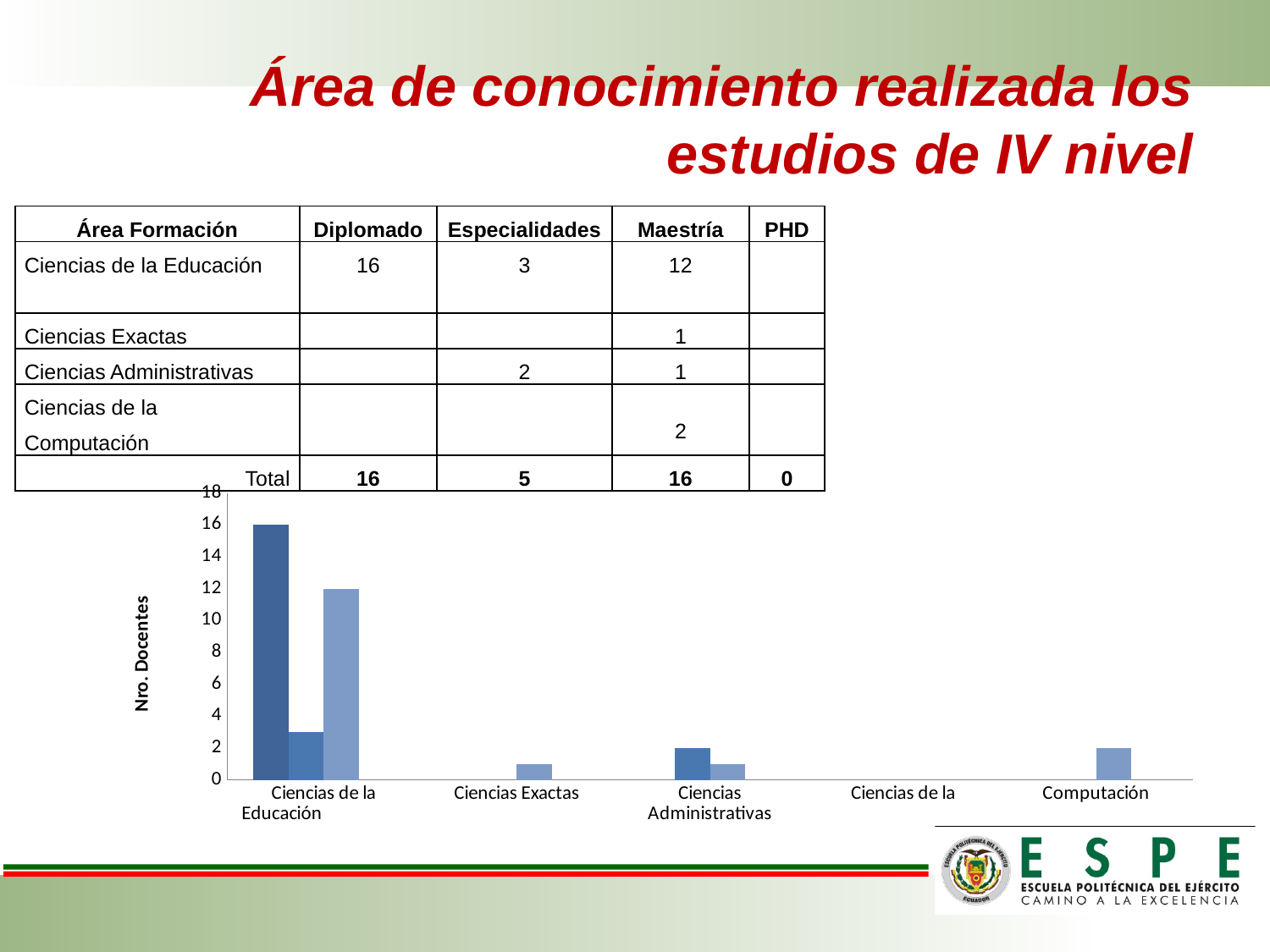
Which has the taller bar: Ciencias de la Educación or Ciencias Administrativas? Ciencias de la Educación What value does the tallest (dark blue) bar for Ciencias de la Educación reach? 16 Is the value of the middle (medium blue) bar for Ciencias de la Educación greater or less than 4? less What is the highest value shown on the vertical axis of the chart? 18 For Ciencias Administrativas, which bar is taller: the dark blue bar or the light blue bar? the dark blue bar What kind of chart is shown on the slide? bar chart What is the title of the vertical axis of the chart? Nro. Docentes Which category on the x axis has the tallest bar in the chart? Ciencias de la Educación What value does the light blue bar for Ciencias de la Educación reach? 12 Is the value of the bar above the Computación label greater or less than 4? less What value does the dark blue bar for Ciencias Administrativas reach? 2 Is the value of the bar for Ciencias Exactas greater or less than 2? less